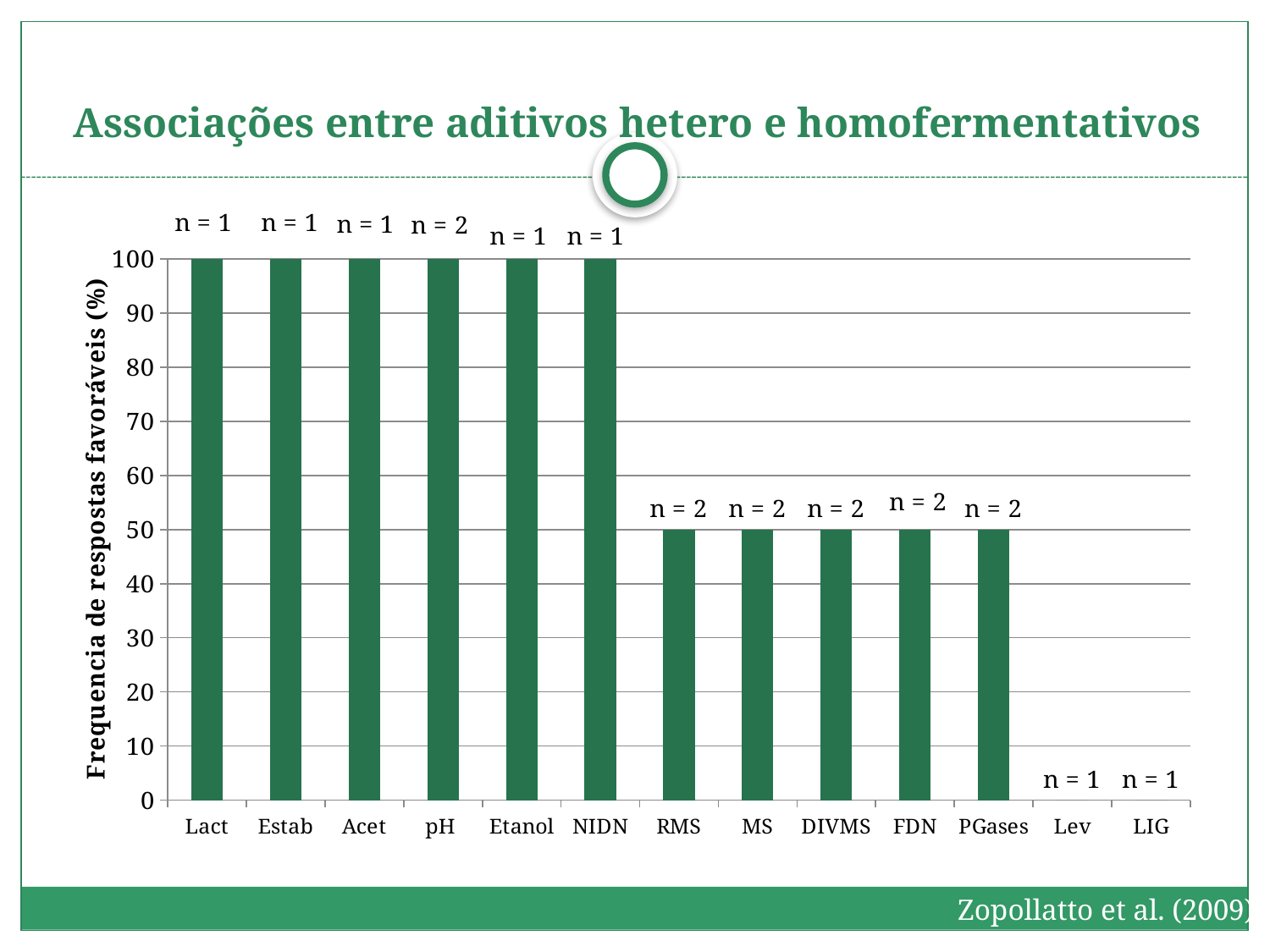
Which is larger, the value for pH or the value for DIVMS? pH What is the data label printed above the bar for pH? n = 2 What kind of chart is shown on the slide? bar chart What is the label on the y axis of the chart? Frequencia de respostas favoráveis (%) Do the values generally rise or fall moving from left to right along the x axis? fall How many categories have a value of 100? 6 What is the value for Lev? 0 What is the value for Lact? 100 What is the difference between the value for Acet and the value for MS? 50 What is the value for FDN? 50 What is the value for RMS? 50 How many categories are shown on the x axis of the chart? 13